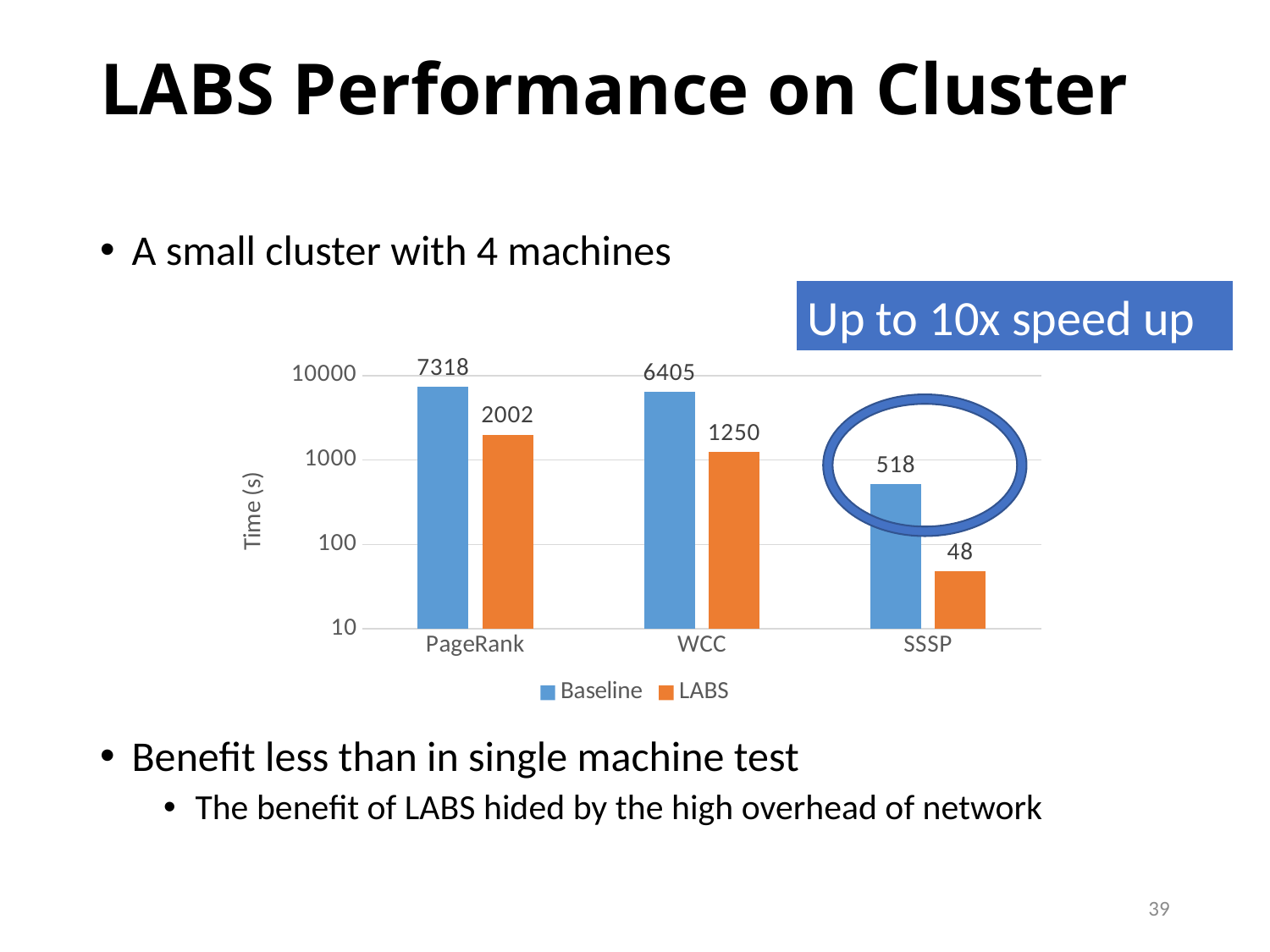
What is the difference between the Baseline and LABS values for SSSP? 470 Which is larger, the LABS value for PageRank or the LABS value for WCC? PageRank What is the Baseline time for PageRank? 7318 What is the difference between the Baseline and LABS values for PageRank? 5316 What is the LABS time for SSSP? 48 Which category has the highest Baseline value? PageRank What is the LABS time for WCC? 1250 Which category has the lowest LABS value? SSSP How many categories are shown on the x axis? 3 How many series does the legend list? 2 Is the Baseline value for SSSP greater or less than 1000? less What kind of chart is shown on the slide? bar chart